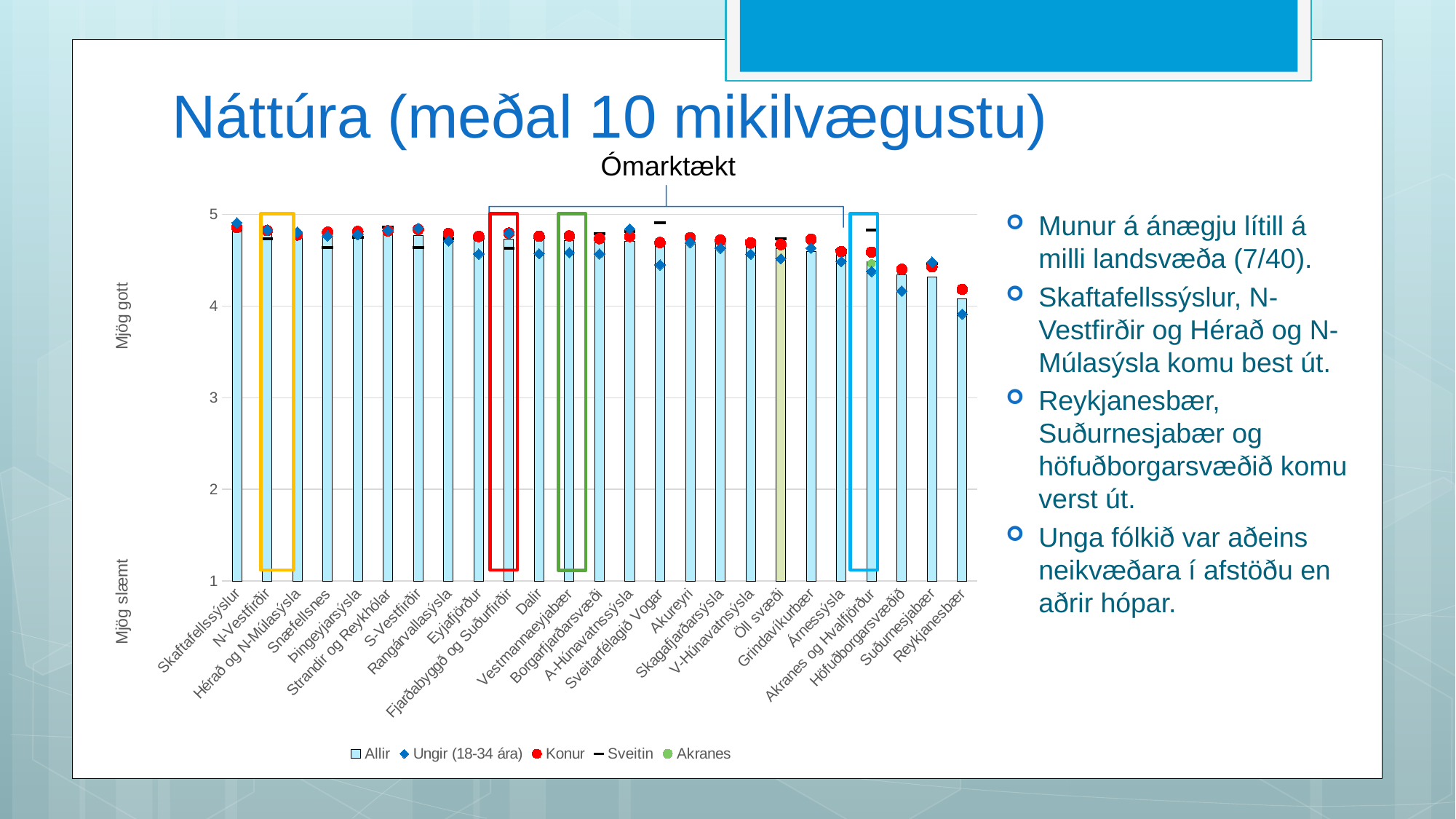
Do the 'Allir' bar values generally rise or fall from left to right along the x axis? fall Is the 'Allir' bar for Skaftafellssýslur greater or less than 4? greater Is the 'Ungir (18-34 ára)' value for Reykjanesbær greater or less than 4? less Is the 'Allir' bar for Suðurnesjabær greater or less than 4? greater How many categories (regions) are shown along the x axis of the chart? 25 Which region has the lowest 'Allir' bar in the chart? Reykjanesbær Which series in the legend is shown with a red circle marker? Konur Which has the larger 'Allir' bar, Suðurnesjabær or Reykjanesbær? Suðurnesjabær How many series does the chart legend list? 5 What kind of chart is shown on the slide? bar chart Which has the larger 'Allir' bar, Skaftafellssýslur or Reykjanesbær? Skaftafellssýslur What is the title of the chart on the slide? Náttúra (meðal 10 mikilvægustu)